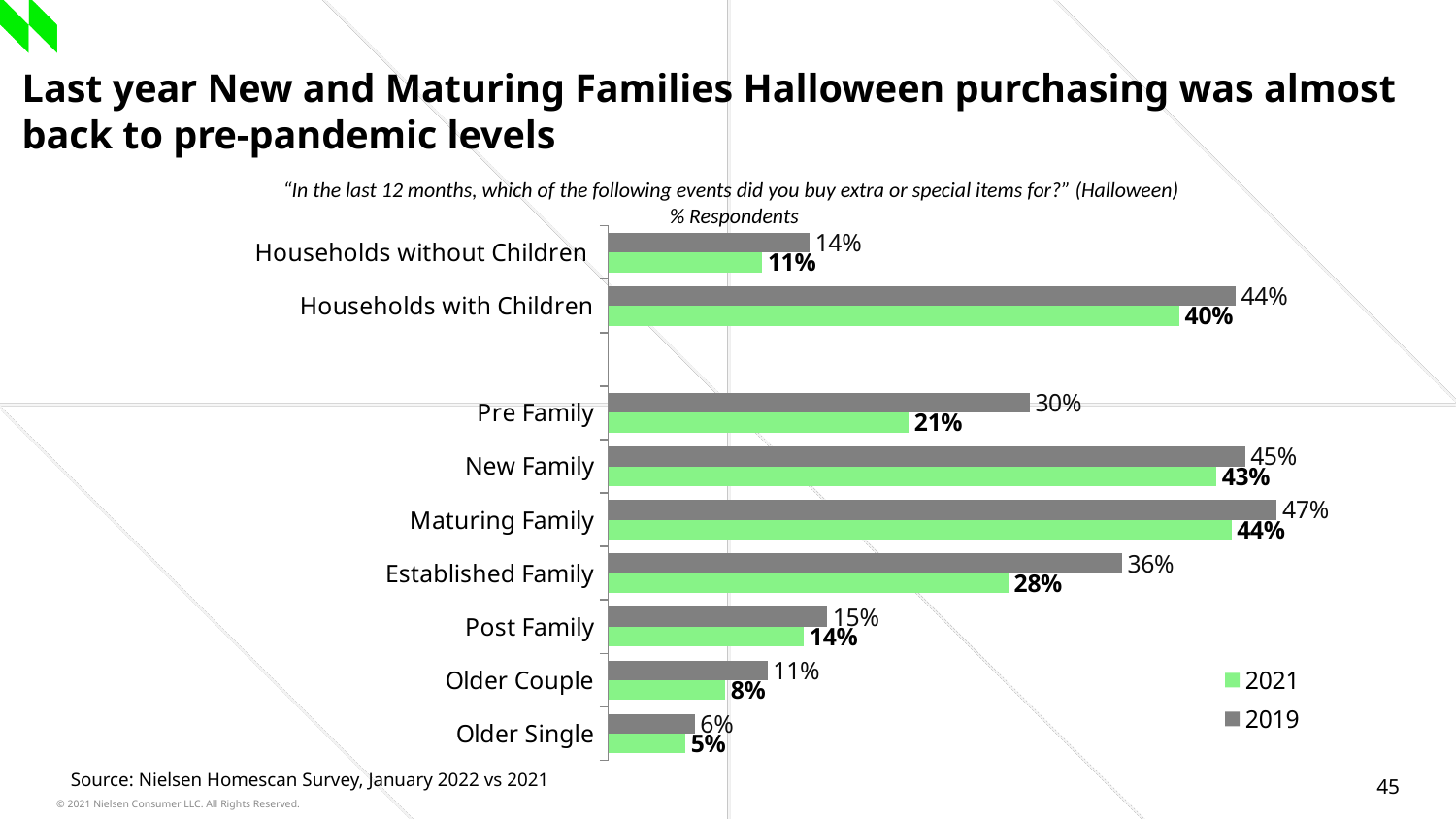
What was the 2019 value for Households with Children? 44% How many categories are shown on the chart? 9 What was the 2021 value for Maturing Family? 44% Which is larger, the 2021 value for New Family or the 2021 value for Established Family? New Family What was the 2021 value for Older Single? 5% What kind of chart is shown on the slide? Bar chart Which category had the lowest 2021 value? Older Single How many series does the legend list? 2 What is the difference between the 2019 and 2021 values for Pre Family? 9% What is the difference between the 2019 and 2021 values for Established Family? 8% Which colour represents the 2021 series in the chart? Green Which category had the highest 2019 value? Maturing Family